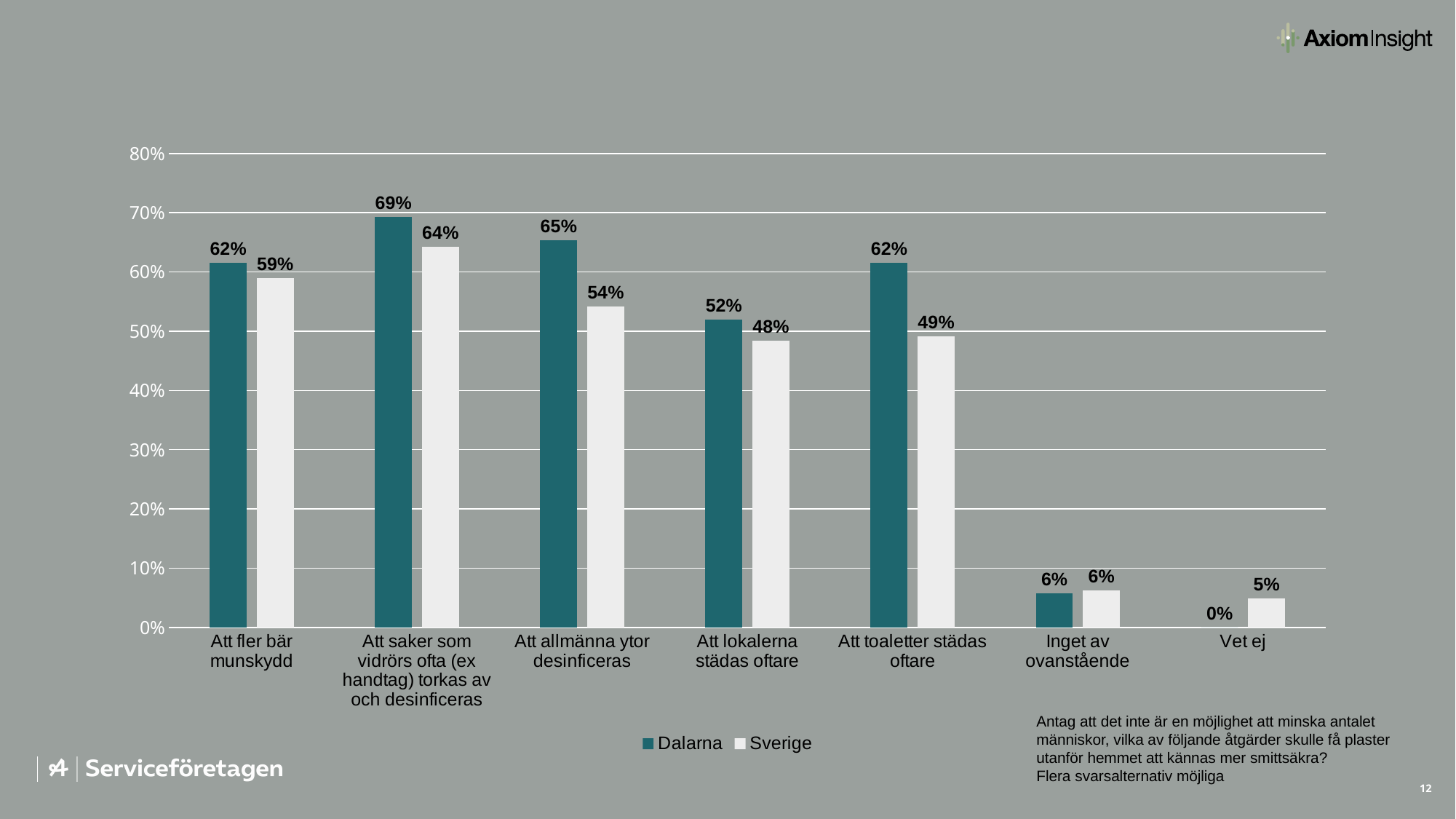
What is the difference between Dalarna and Sverige for "Att toaletter städas oftare"? 13% Which category has the highest value for Dalarna? Att saker som vidrörs ofta (ex handtag) torkas av och desinficeras What is the value for Sverige for "Att fler bär munskydd"? 59% Which is larger for "Att lokalerna städas oftare": Dalarna or Sverige? Dalarna How many categories are shown on the x axis? 7 What is the value for Dalarna for "Vet ej"? 0% Which category has the lowest value for Sverige? Vet ej What is the value for Sverige for "Att allmänna ytor desinficeras"? 54% Which series is shown in dark teal in the legend? Dalarna How many series does the legend list? 2 What is the value for Dalarna for "Att saker som vidrörs ofta (ex handtag) torkas av och desinficeras"? 69% What kind of chart is shown on the slide? Bar chart